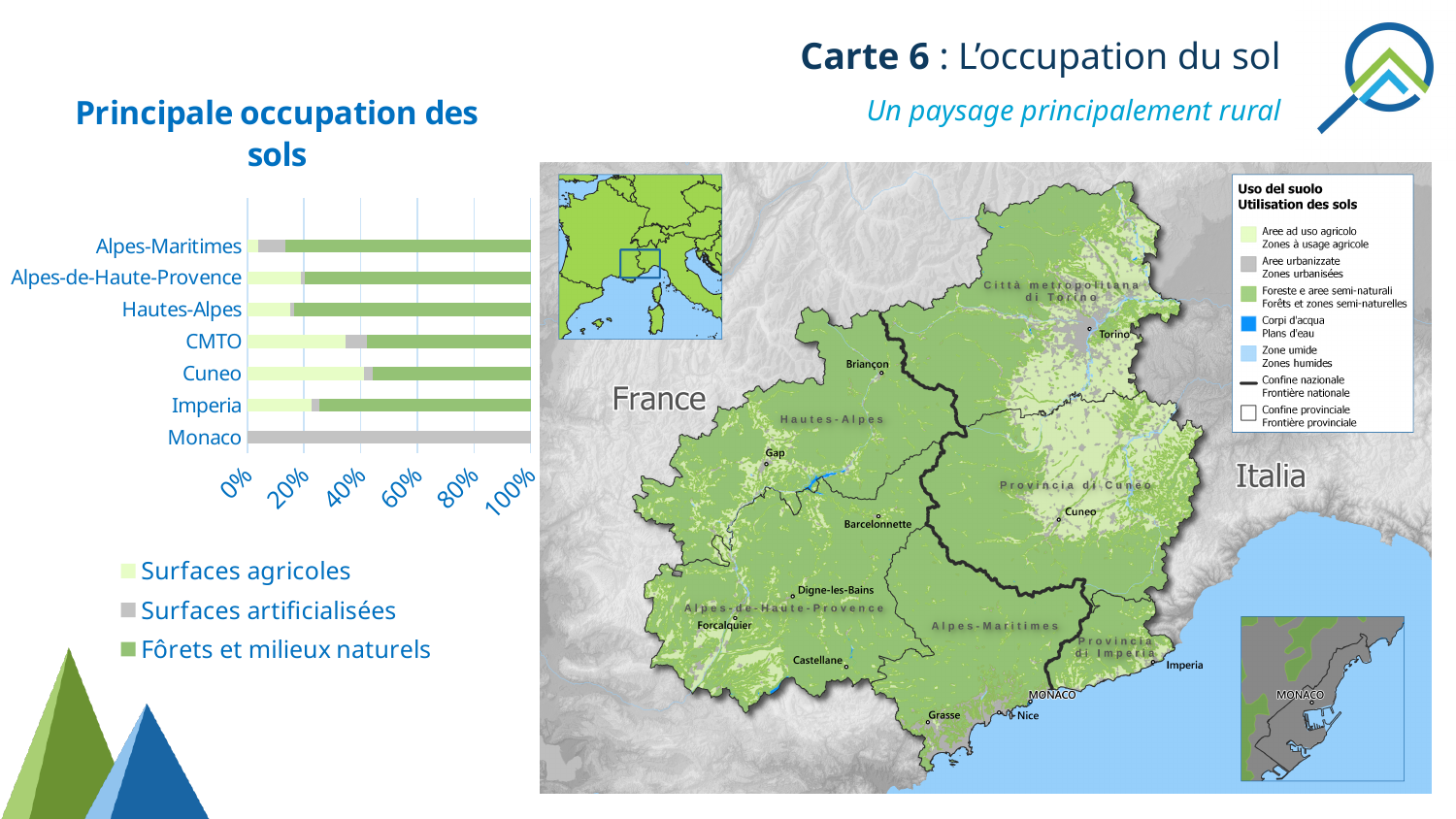
In the "Principale occupation des sols" chart, which series is shown in grey? Surfaces artificialisées How many series does the legend of the "Principale occupation des sols" chart list? 3 What kind of chart is shown under the title "Principale occupation des sols"? Stacked bar chart In the "Principale occupation des sols" chart, is the share of Surfaces artificialisées for Monaco greater or less than 80%? greater In the "Principale occupation des sols" chart, which territory has the largest share of Surfaces artificialisées? Monaco In the "Principale occupation des sols" chart, which territory has the largest share of Surfaces agricoles? Cuneo In the "Principale occupation des sols" chart, which territory has the smallest share of Surfaces agricoles? Monaco In the "Principale occupation des sols" chart, is the share of Surfaces agricoles for CMTO greater or less than 20%? greater How many territories are listed on the y axis of the "Principale occupation des sols" chart? 7 In the "Principale occupation des sols" chart, which has a larger share of Surfaces agricoles, Cuneo or Alpes-Maritimes? Cuneo In the "Principale occupation des sols" chart, which series is shown in dark green? Fôrets et milieux naturels In the "Principale occupation des sols" chart, is the share of Surfaces agricoles for Alpes-Maritimes greater or less than 20%? less